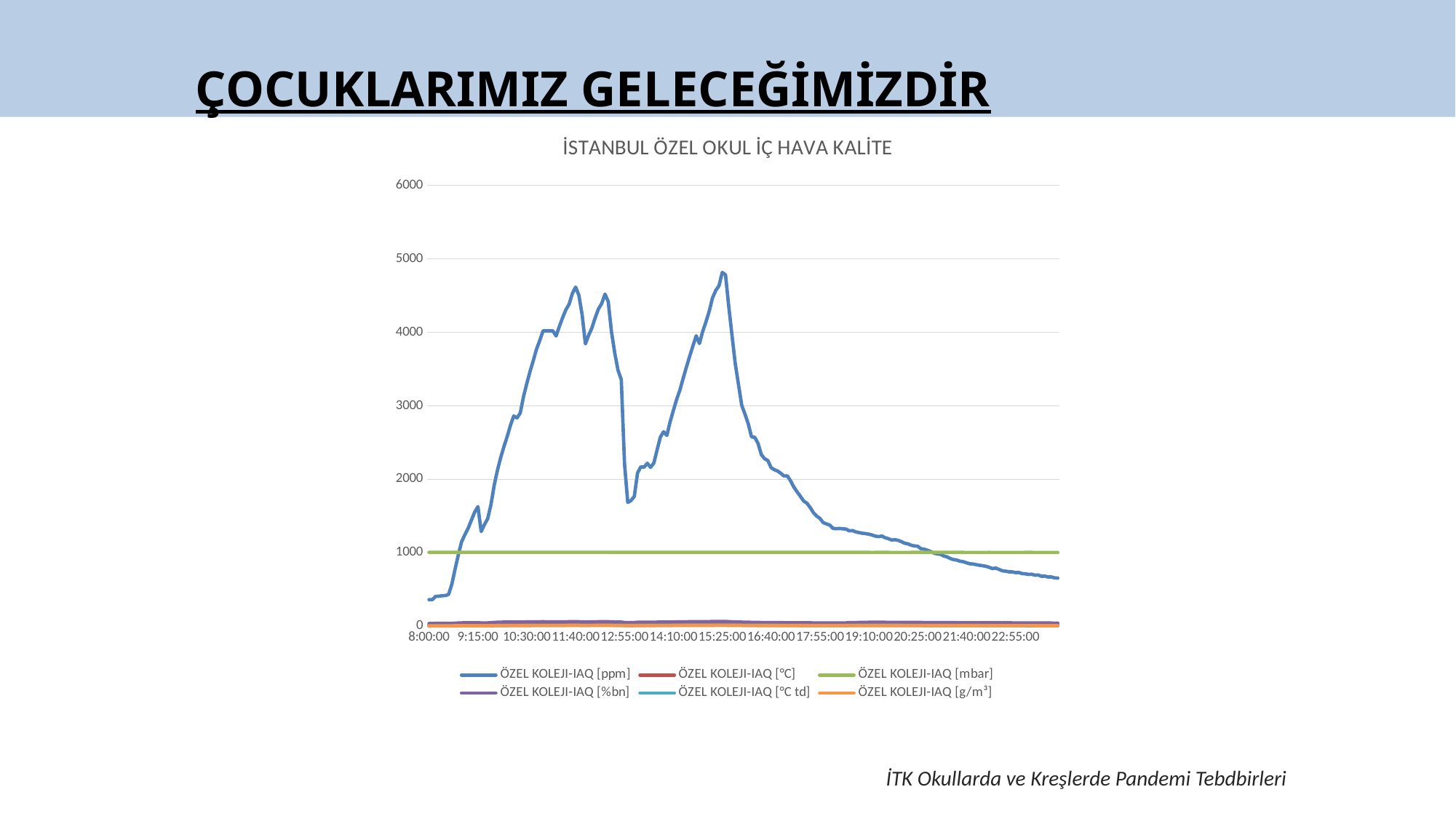
Which is larger for ÖZEL KOLEJI-IAQ [ppm]: the value at 10:30:00 or the value at 19:10:00? 10:30:00 What kind of chart is shown on the slide? line chart How many time labels are shown on the x axis? 13 Which series reaches the highest value on the chart? ÖZEL KOLEJI-IAQ [ppm] Which series is drawn in green? ÖZEL KOLEJI-IAQ [mbar] Is the value of ÖZEL KOLEJI-IAQ [ppm] at 22:55:00 greater or less than 1000? less How many series does the legend list? 6 Does the ÖZEL KOLEJI-IAQ [ppm] line rise or fall between 15:25:00 and 22:55:00? fall Is the value of ÖZEL KOLEJI-IAQ [ppm] at 8:00:00 greater or less than 1000? less What is the title of the chart? İSTANBUL ÖZEL OKUL İÇ HAVA KALİTE Is the value of ÖZEL KOLEJI-IAQ [ppm] at 14:10:00 greater or less than 2000? greater